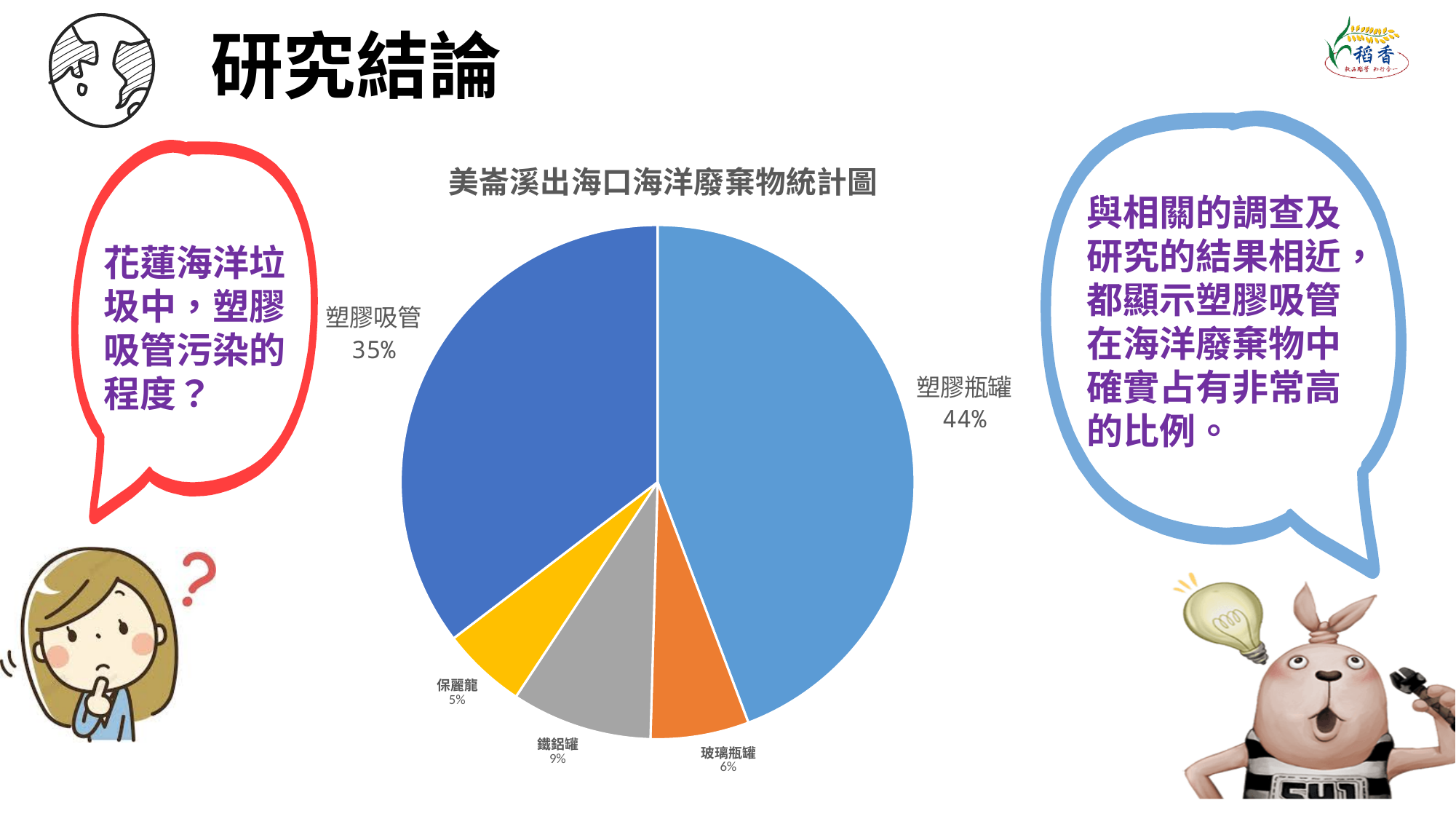
What is the title of the chart? 美崙溪出海口海洋廢棄物統計圖 How many categories are shown in the pie chart? 5 Which category has the largest share of the pie? 塑膠瓶罐 What percentage of the pie is 塑膠瓶罐? 44% Which has a larger share, 鐵鋁罐 or 玻璃瓶罐? 鐵鋁罐 What percentage of the pie is 塑膠吸管? 35% What percentage of the pie is 玻璃瓶罐? 6% What percentage of the pie is 鐵鋁罐? 9% What percentage of the pie is 保麗龍? 5% What type of chart is shown on the slide? pie chart What is the difference in percentage points between 塑膠瓶罐 and 塑膠吸管? 9 Which category has the smallest share of the pie? 保麗龍